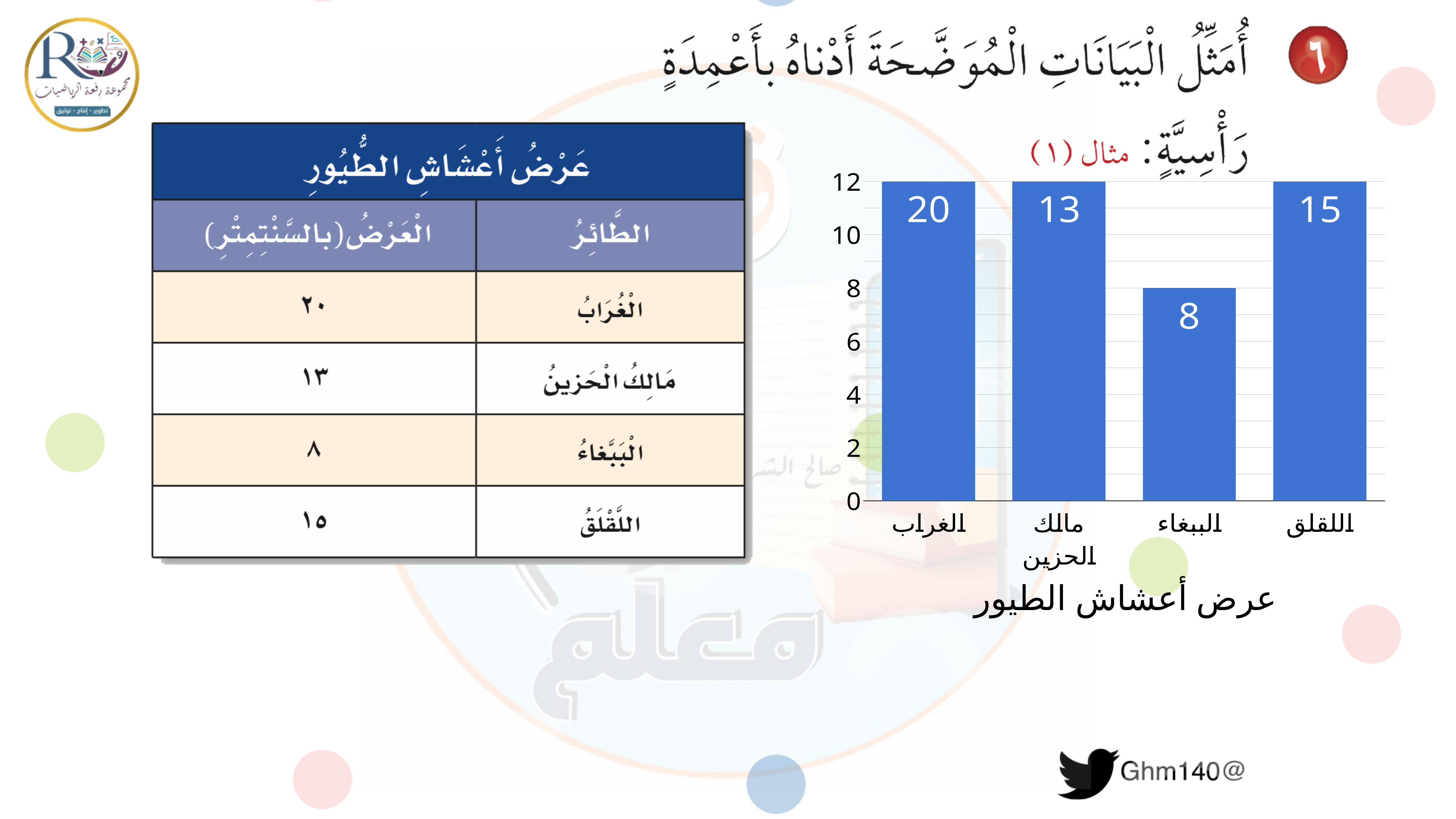
What is the difference between the values for اللقلق and مالك الحزين? 2 What kind of chart is shown on the slide? bar chart What is the value shown for الغراب in the chart? 20 Which has a larger value, اللقلق or مالك الحزين? اللقلق How many birds (categories) are shown in the chart? 4 What is the value shown for الببغاء in the chart? 8 What is the difference between the values for الغراب and الببغاء? 12 What is the value shown for مالك الحزين in the chart? 13 Which bird has the highest value in the chart? الغراب Which bird has the lowest value in the chart? الببغاء Is the value for الببغاء greater or less than 10? less What is the value shown for اللقلق in the chart? 15